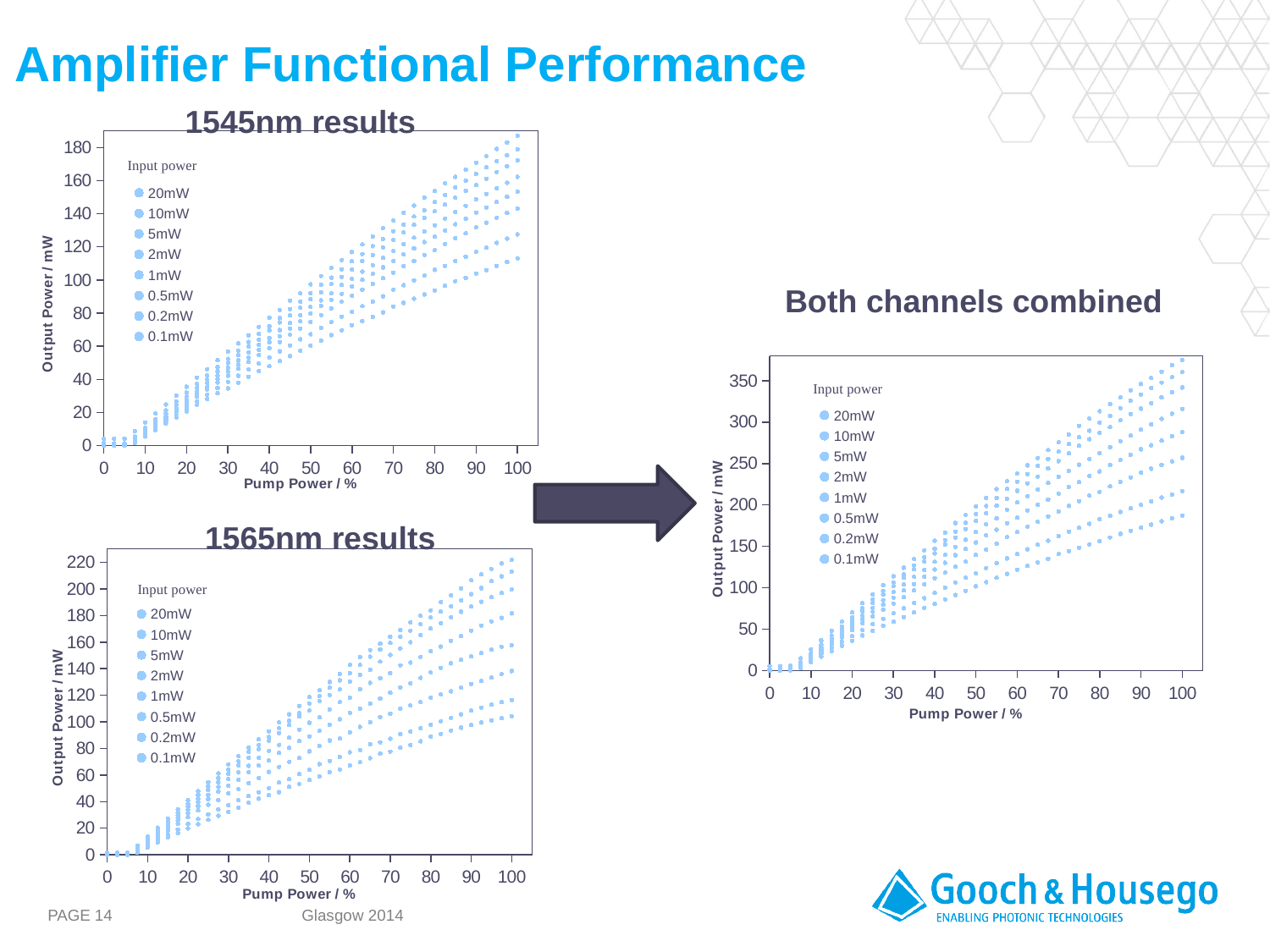
In the 'Both channels combined' chart, which series has the larger output power at 100% pump power, 20mW or 0.1mW? 20mW In the '1565nm results' chart, which input power series has the lowest output power at 100% pump power? 0.1mW What is the x-axis title of the '1565nm results' chart? Pump Power / % In the 'Both channels combined' chart, does output power rise or fall as pump power increases? rise In the 'Both channels combined' chart, is the output power of the 20mW series at 100% pump power greater or less than 350? greater In the '1545nm results' chart, which input power series reaches the highest output power? 20mW What is the title of the legend in the 'Both channels combined' chart? Input power What kind of chart is the '1545nm results' chart? scatter chart How many series does the legend of the '1565nm results' chart list? 8 In the '1565nm results' chart, is the output power of the 20mW series at 100% pump power greater or less than 200? greater How many charts are shown on the slide? 3 In the '1545nm results' chart, is the output power of the 0.1mW series at 100% pump power greater or less than 100? greater